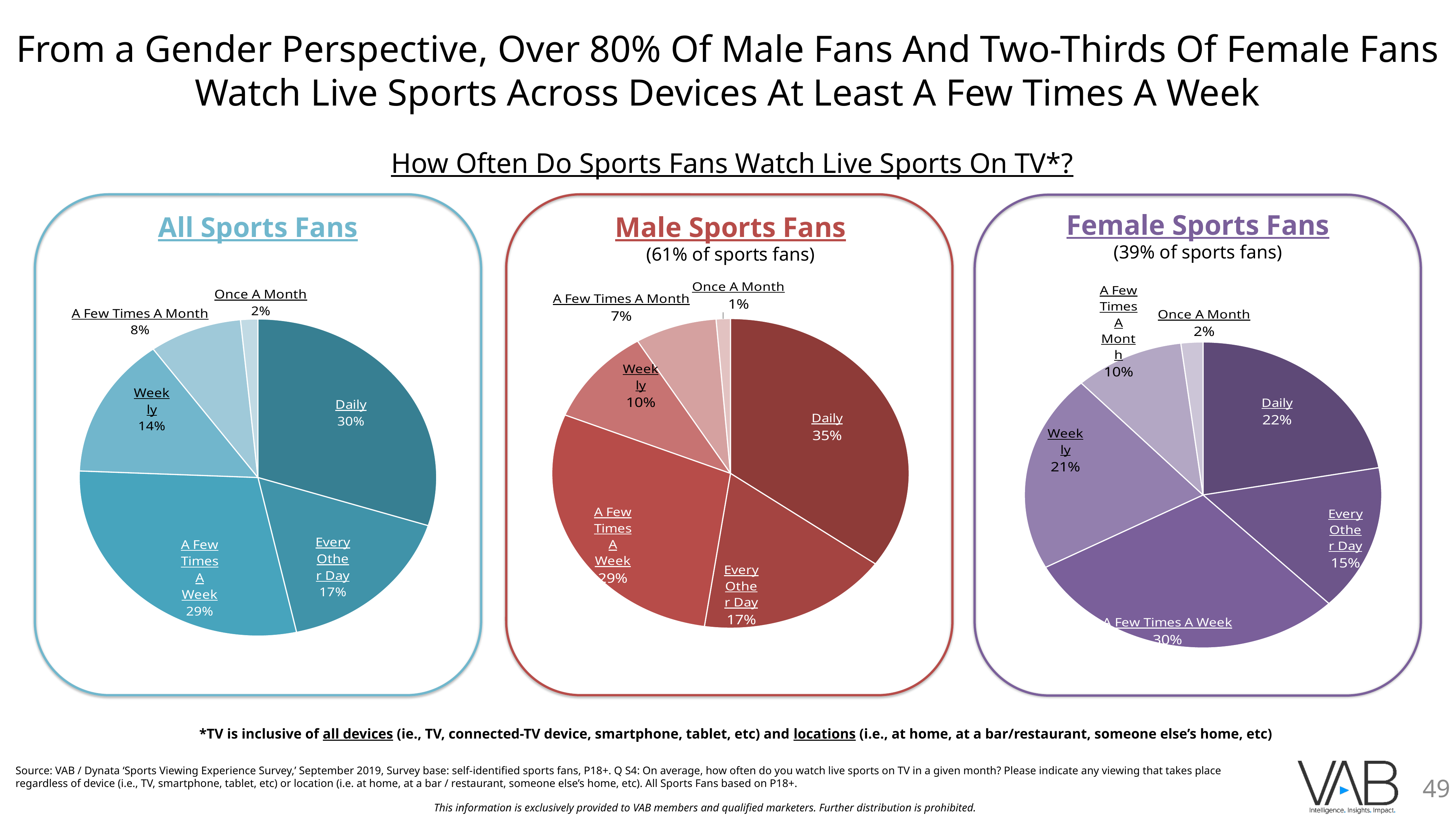
In the Male Sports Fans pie chart, what share of fans watch live sports on TV daily? 35% In the Female Sports Fans pie chart, what share of fans watch live sports on TV weekly? 21% Which is larger: the Daily share for Male Sports Fans or the Daily share for Female Sports Fans? Male Sports Fans In the Female Sports Fans pie chart, what is the combined share of Daily and Every Other Day? 37% In the Female Sports Fans pie chart, which category has the largest share? A Few Times A Week In the All Sports Fans pie chart, what is the difference between the Daily share and the Weekly share? 16% According to the Male Sports Fans chart subtitle, what percentage of sports fans are male? 61% In the All Sports Fans pie chart, what share of fans watch live sports on TV daily? 30% In the Male Sports Fans pie chart, what share of fans watch live sports on TV a few times a month? 7% In the Male Sports Fans pie chart, which category has the smallest share? Once A Month What type of chart is used for the Male Sports Fans data? Pie chart How many categories does the All Sports Fans pie chart show? 6